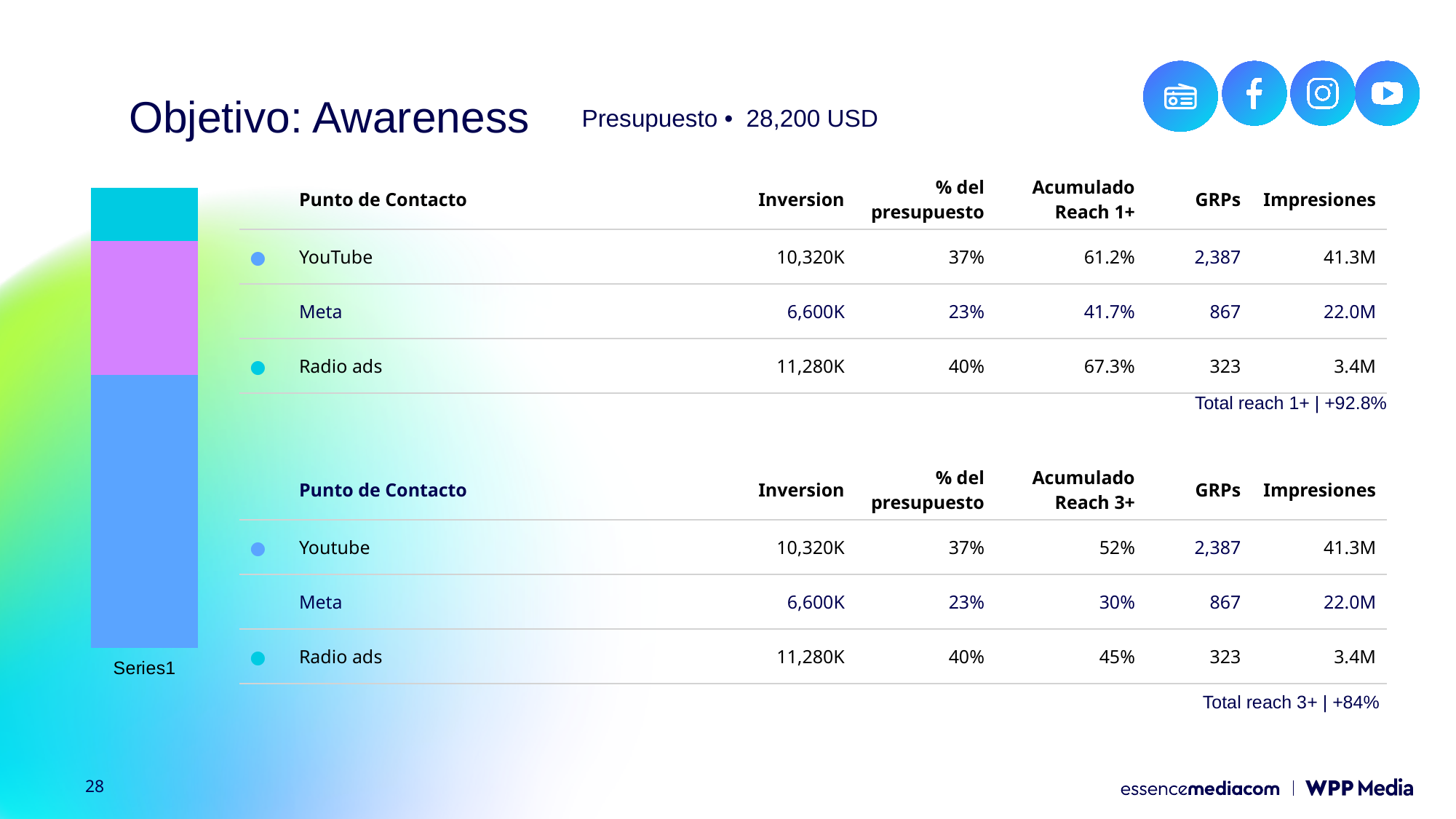
In the chart on the left of the slide, which segment of the stacked bar is the largest: the blue, the purple or the cyan one? blue How many segments make up the stacked bar in the chart on the left of the slide? 3 In the chart on the left of the slide, which segment of the stacked bar is the smallest: the blue, the purple or the cyan one? cyan In the chart on the left of the slide, which colour is the segment at the bottom of the stacked bar? blue What kind of chart is shown on the left of the slide? stacked bar chart How many bars does the chart on the left of the slide show? 1 What is the category label under the bar in the chart on the left of the slide? Series1 In the chart on the left of the slide, which segment is larger: the purple segment or the cyan segment? purple